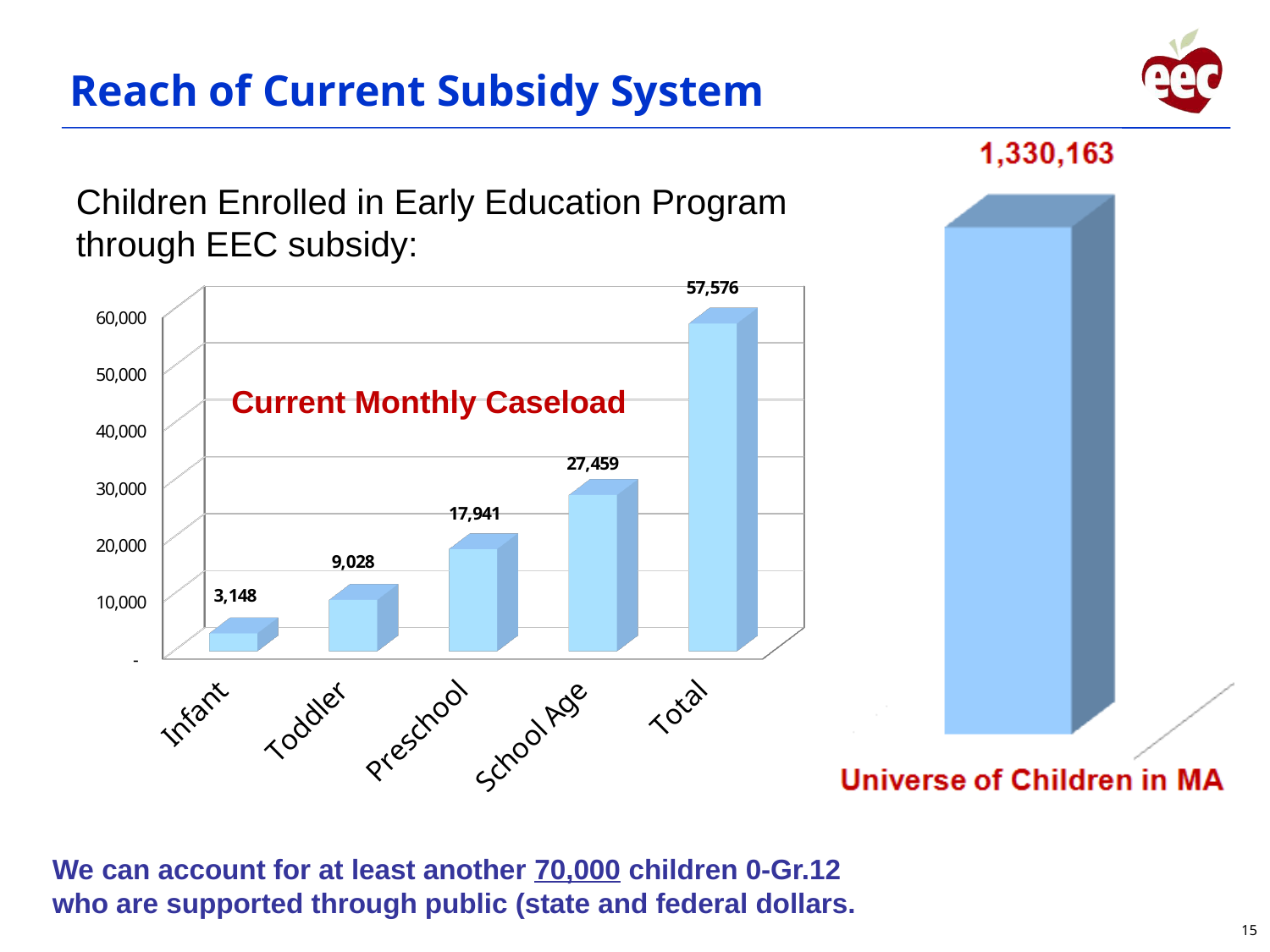
In the Current Monthly Caseload chart, what is the value for Preschool? 17,941 In the Current Monthly Caseload chart, which is larger, Toddler or Preschool? Preschool In the Current Monthly Caseload chart, what is the value for Infant? 3,148 In the Universe of Children in MA chart on the right, what value is shown on the bar? 1,330,163 In the Current Monthly Caseload chart, which category has the lowest value? Infant What kind of chart is the Current Monthly Caseload chart? Bar chart In the Current Monthly Caseload chart, how many categories are shown on the x axis? 5 In the Current Monthly Caseload chart, do the values rise or fall from Infant to Total along the x axis? Rise In the Current Monthly Caseload chart, which age group (excluding Total) has the highest value? School Age In the Current Monthly Caseload chart, what is the value for School Age? 27,459 In the Current Monthly Caseload chart, what is the difference between the School Age and Toddler values? 18,431 In the Current Monthly Caseload chart, what is the value for Total? 57,576